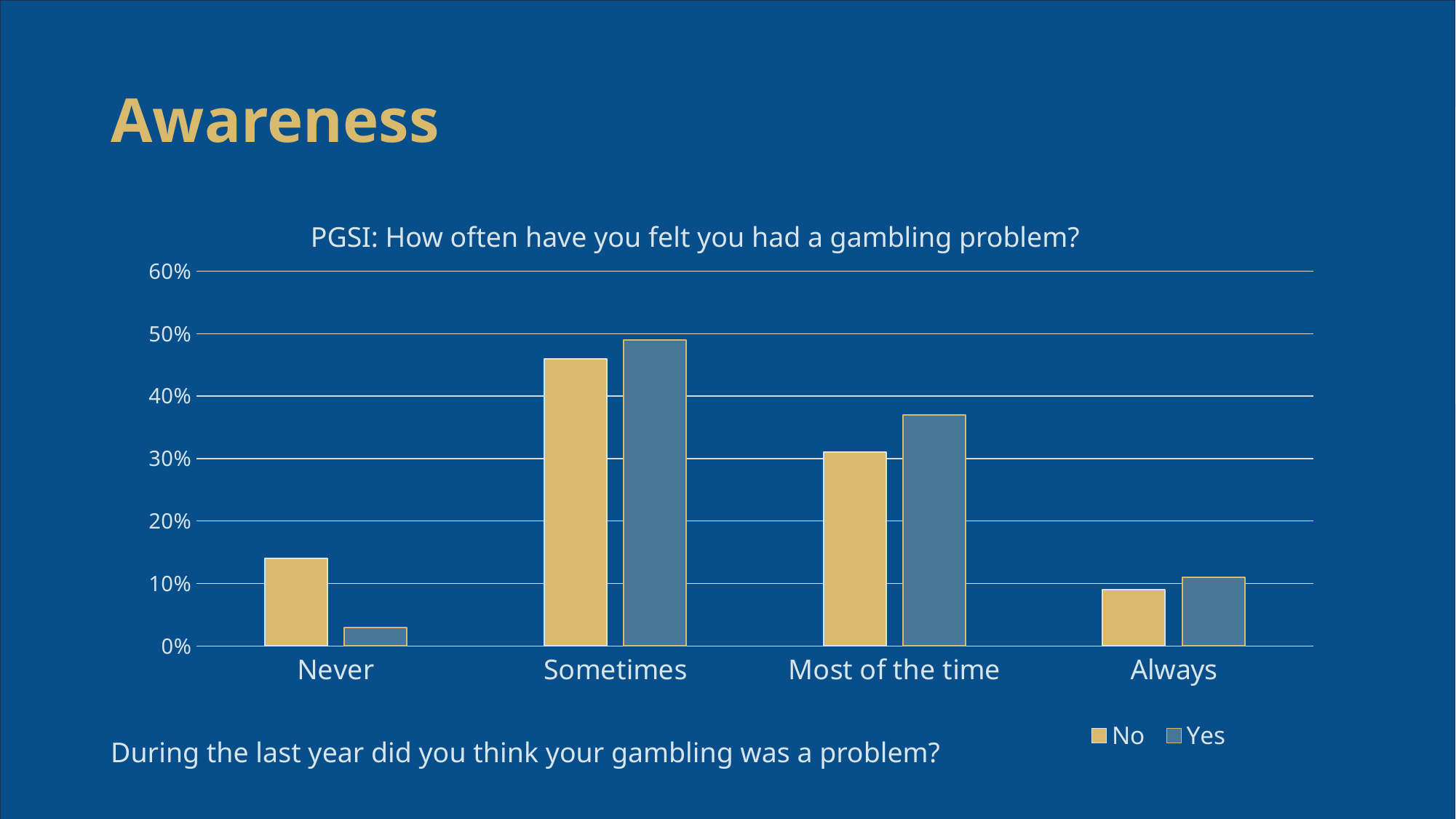
What is the title of the chart? PGSI: How often have you felt you had a gambling problem? What kind of chart is shown on the slide? bar chart How many categories are shown on the x axis? 4 Which category has the highest value for the Yes series? Sometimes Which category has the lowest value for the Yes series? Never How many series does the legend list? 2 Is the value for No in the Sometimes category greater or less than 40%? greater Which category has the highest value for the No series? Sometimes Is the value for Yes in the Most of the time category greater or less than 40%? less Is the value for No in the Never category greater or less than 10%? greater For the Most of the time category, which series has the larger value, No or Yes? Yes For the Never category, which series has the larger value, No or Yes? No